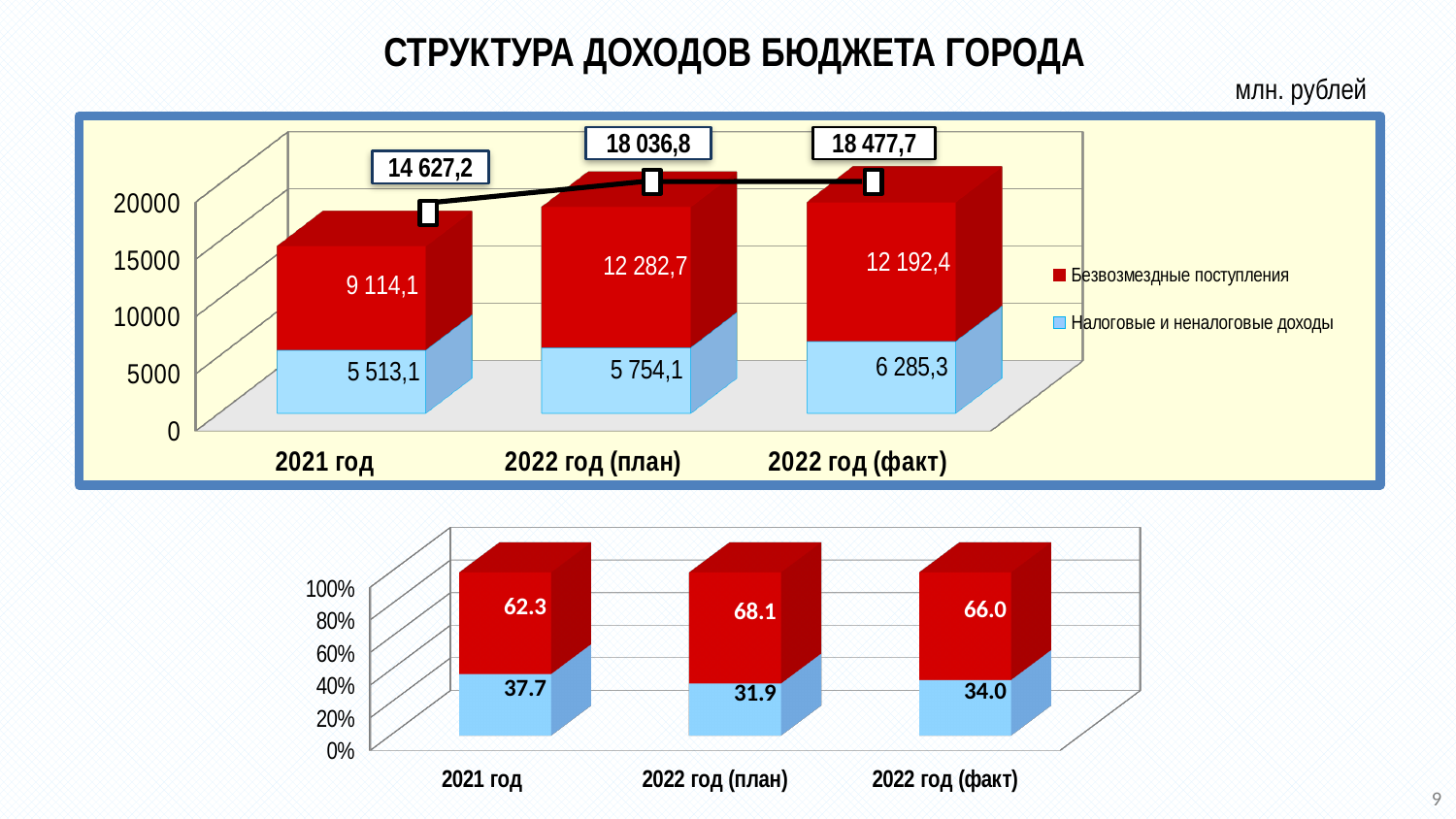
In the top chart, how many categories are shown on the x axis? 3 What kind of chart is the bottom chart? bar chart In the top chart, what is the difference between Налоговые и неналоговые доходы for 2022 год (факт) and 2022 год (план)? 531,2 In the top chart, how many series does the legend list? 2 In the top chart, do the totals rise or fall from 2021 год to 2022 год (факт)? rise In the top chart, what is the value of Налоговые и неналоговые доходы for 2022 год (факт)? 6 285,3 In the top chart, what is the total shown above the bar for 2022 год (план)? 18 036,8 In the top chart, what is the value of Безвозмездные поступления for 2021 год? 9 114,1 In the top chart, which category has the highest total? 2022 год (факт) In the top chart, which category has the lowest value for Налоговые и неналоговые доходы? 2021 год In the bottom chart, what is the value of the red segment for 2022 год (план)? 68.1 In the top chart, which is larger for Безвозмездные поступления: 2022 год (план) or 2022 год (факт)? 2022 год (план)